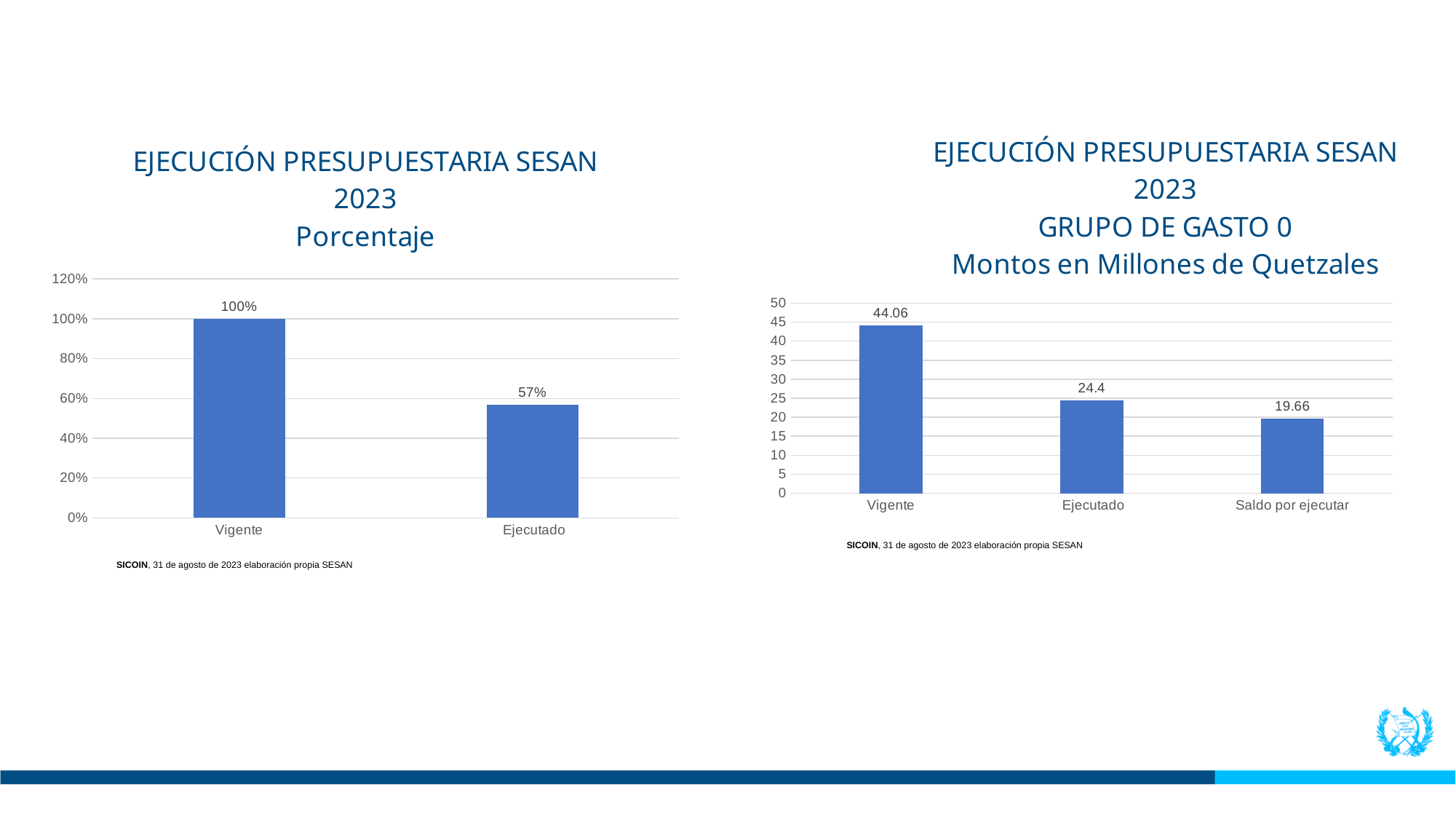
In the right chart (Grupo de Gasto 0), which category has the lowest value? Saldo por ejecutar In the left chart (Porcentaje), what is the value for Vigente? 100% In the right chart (Grupo de Gasto 0), how many categories are shown? 3 In the right chart (Grupo de Gasto 0), is the value for Ejecutado larger or smaller than the value for Saldo por ejecutar? Larger In the left chart (Porcentaje), what is the value for Ejecutado? 57% In the left chart (Porcentaje), how many categories are shown? 2 In the right chart (Grupo de Gasto 0), what is the value for Saldo por ejecutar? 19.66 In the left chart (Porcentaje), what is the difference between Vigente and Ejecutado? 43% In the right chart (Grupo de Gasto 0), what is the value for Vigente? 44.06 What kind of chart is the left chart (Porcentaje)? Bar chart In the right chart (Grupo de Gasto 0), what is the difference between Ejecutado and Saldo por ejecutar? 4.74 In the right chart (Grupo de Gasto 0), which category has the highest value? Vigente